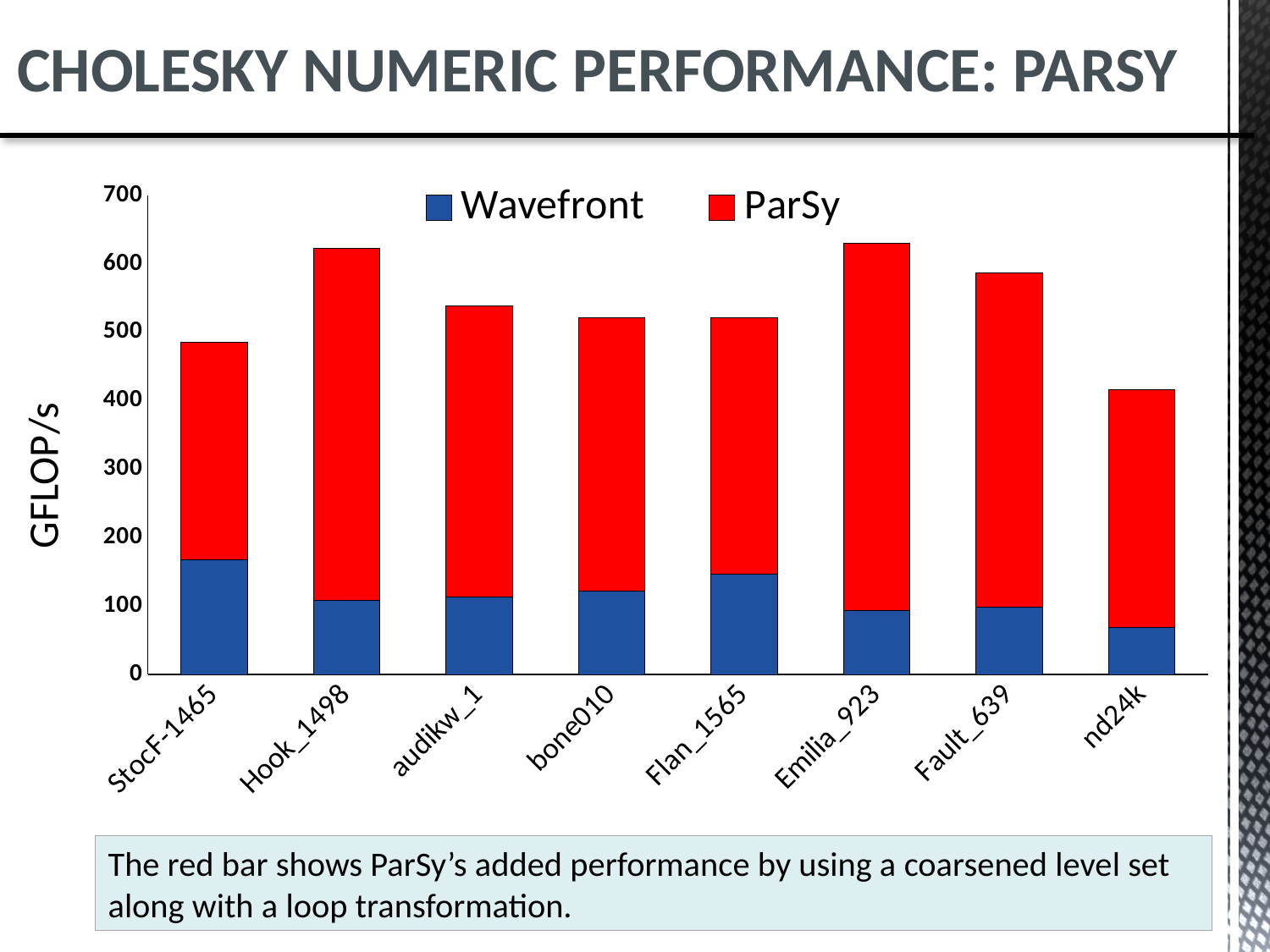
What is the label on the y axis? GFLOP/s Which category has the highest Wavefront (blue) value? StocF-1465 Is the total bar height for Hook_1498 greater or less than 600? greater Which category has the lowest total bar height? nd24k How many matrices (categories) are shown on the x axis? 8 Which has the larger total bar height, Fault_639 or nd24k? Fault_639 Which category has the lowest Wavefront (blue) value? nd24k Is the Wavefront value for nd24k greater or less than 100? less What kind of chart is shown on the slide? stacked bar chart How many series does the legend list? 2 Which has the larger total bar height, StocF-1465 or audikw_1? audikw_1 Is the total bar height for StocF-1465 greater or less than 500? less